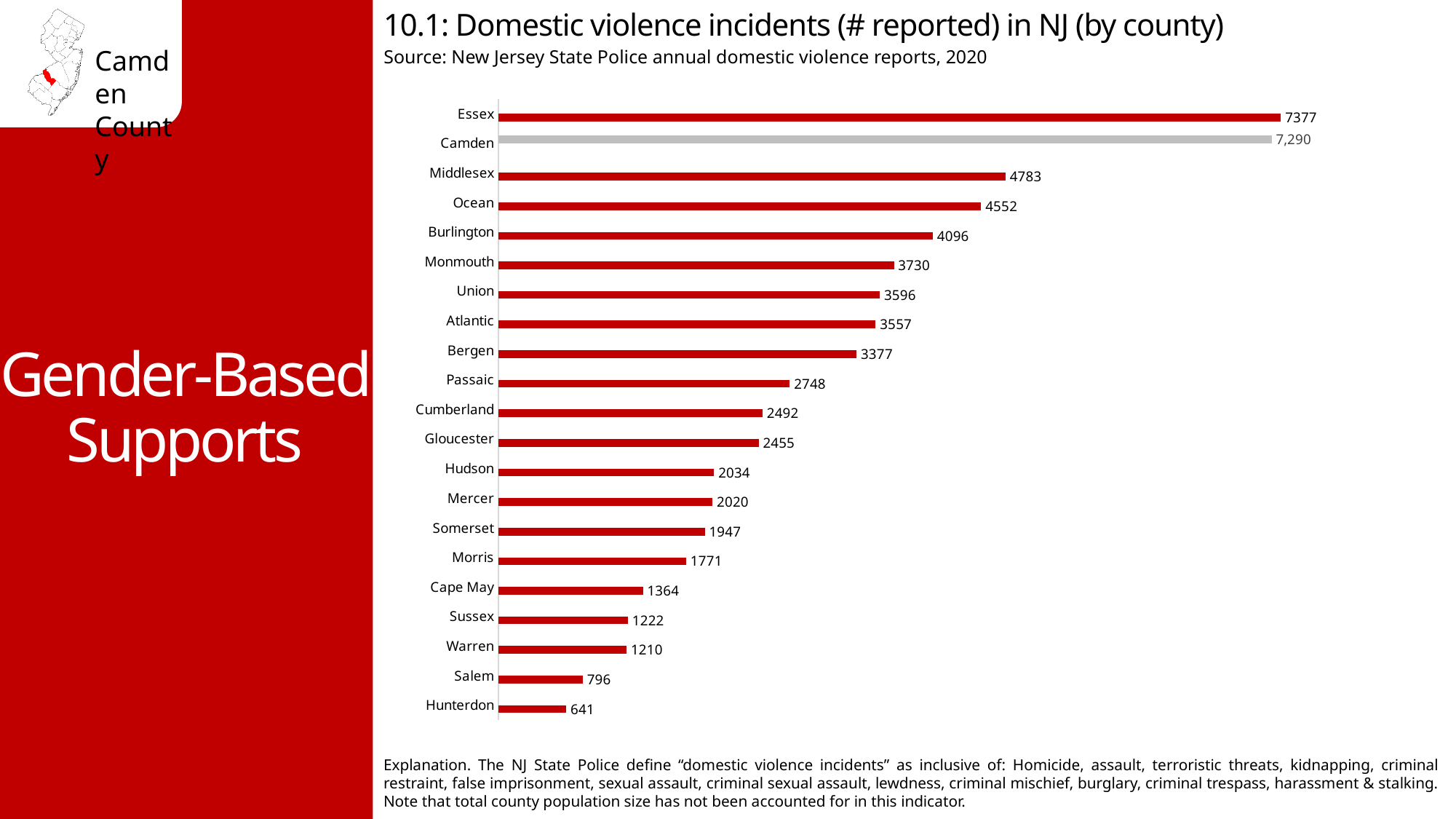
What is the difference between the values for Ocean and Burlington? 456 How many domestic violence incidents were reported in Camden county? 7,290 Which county has the lowest number of reported domestic violence incidents? Hunterdon Which county has a larger value, Monmouth or Bergen? Monmouth Which county's bar is coloured grey instead of red? Camden How many counties are shown in the chart? 21 What is the difference between the values for Essex and Camden? 87 What is the value shown for Middlesex county? 4783 Which county has a larger value, Salem or Sussex? Sussex What kind of chart is used on this slide? Bar chart What is the value shown for Cape May county? 1364 Which county has the highest number of reported domestic violence incidents? Essex